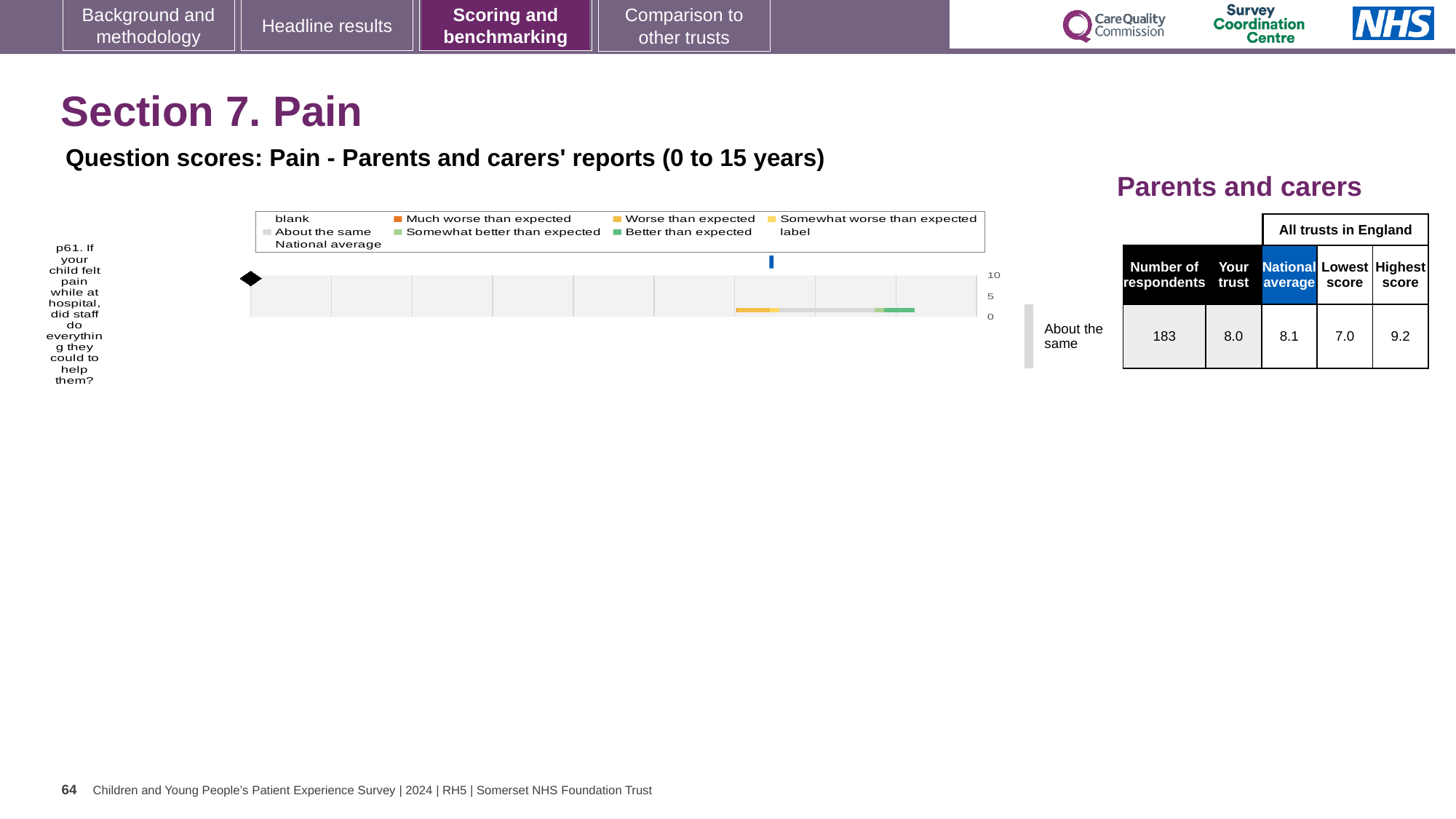
How many survey questions are plotted in the chart? 1 What is the highest value shown on the chart's axis? 10 What is the lowest score among all trusts in England for question p61? 7.0 Which is larger for question p61, the 'Your trust' score or the national average? National average What is the highest score among all trusts in England for question p61? 9.2 What kind of chart is shown on the slide? bar chart How many respondents answered question p61? 183 What is the difference between the highest score and the lowest score for question p61? 2.2 What is the 'Your trust' score for question p61? 8.0 Which benchmarking category does the trust fall into for question p61? About the same What is the national average score for question p61? 8.1 Is the 'Your trust' score for question p61 greater or less than 5? greater